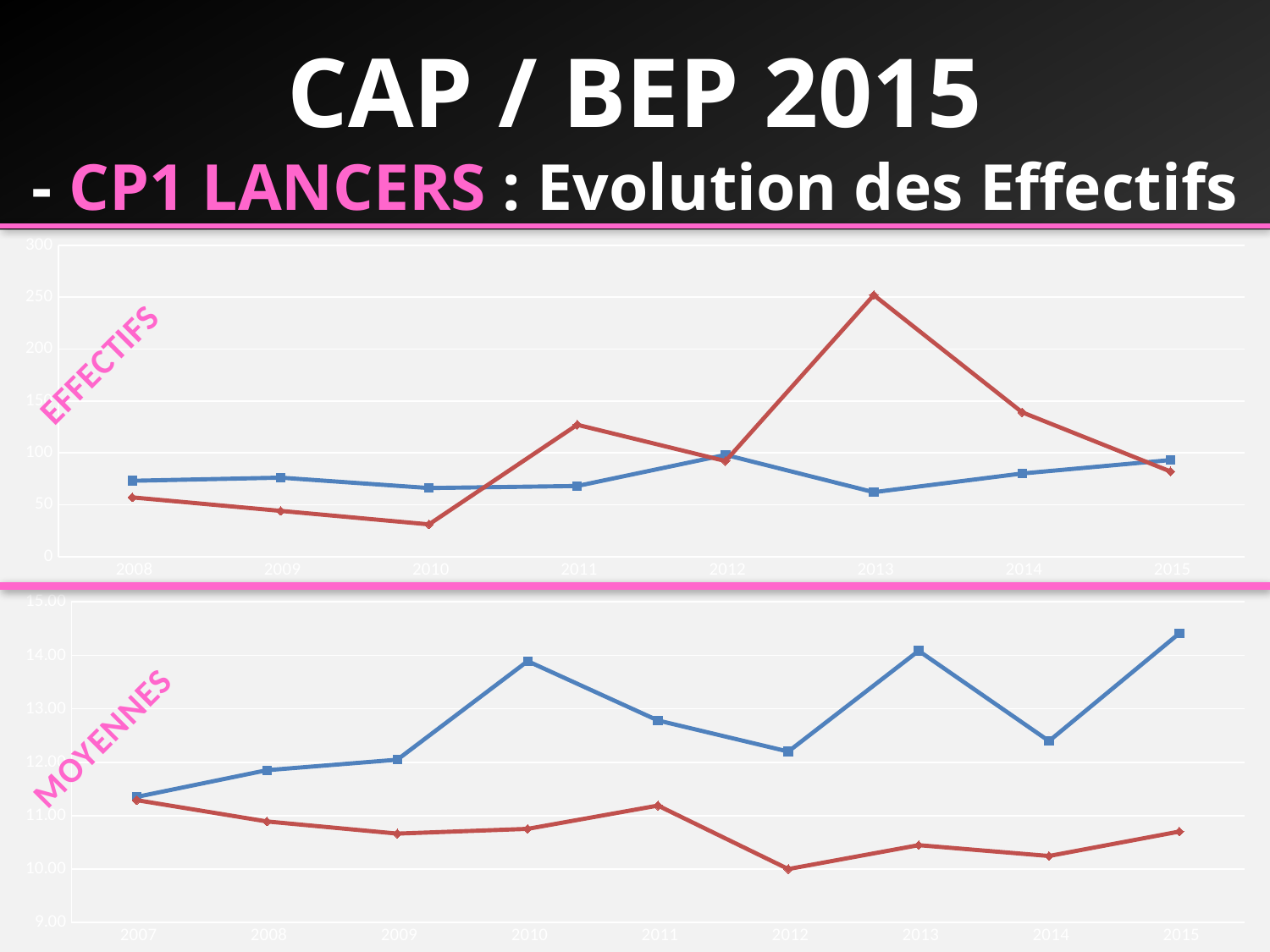
In the bottom chart (MOYENNES), is the value of the blue line in 2015 greater or less than 14.00? greater In the bottom chart (MOYENNES), in which year does the blue line reach its highest value? 2015 In the top chart (EFFECTIFS), does the red line rise or fall from 2013 to 2015? fall In the bottom chart (MOYENNES), how many years are shown on the x axis? 9 In the top chart (EFFECTIFS), is the value of the red line in 2010 greater or less than 50? less In the top chart (EFFECTIFS), which line has the larger value in 2013, the blue line or the red line? the red line In the top chart (EFFECTIFS), is the value of the red line in 2013 greater or less than 200? greater In the bottom chart (MOYENNES), which line has the larger value in 2010, the blue line or the red line? the blue line In the top chart (EFFECTIFS), how many years are shown on the x axis? 8 In the top chart (EFFECTIFS), in which year does the red line reach its highest value? 2013 What type of chart is the top chart (EFFECTIFS)? line chart In the top chart (EFFECTIFS), in which year does the red line reach its lowest value? 2010